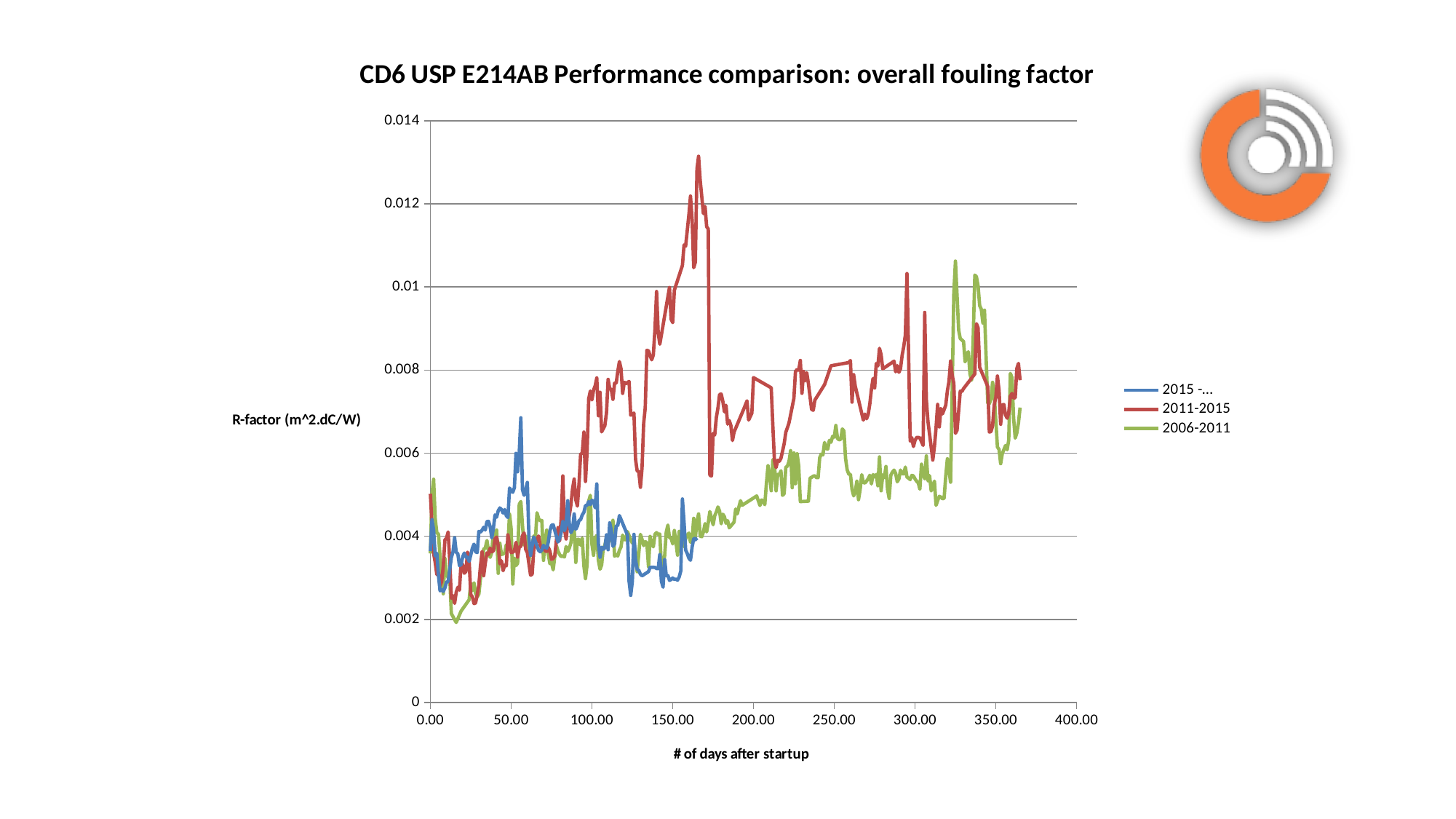
What is the label of the x axis? # of days after startup Is the value of the 2011-2015 series at 200 days after startup greater or less than 0.006? greater Which series stops earliest along the x axis? 2015 - What kind of chart is shown on the slide? Line chart Is the peak value of the 2011-2015 series greater or less than 0.012? greater Is the value of the 2006-2011 series at 300 days after startup greater or less than 0.008? less Does the 2011-2015 series generally rise or fall between 0 and 150 days after startup? rise How many series does the legend list? 3 What is the title of the chart? CD6 USP E214AB Performance comparison: overall fouling factor Which series reaches the highest R-factor value on the chart? 2011-2015